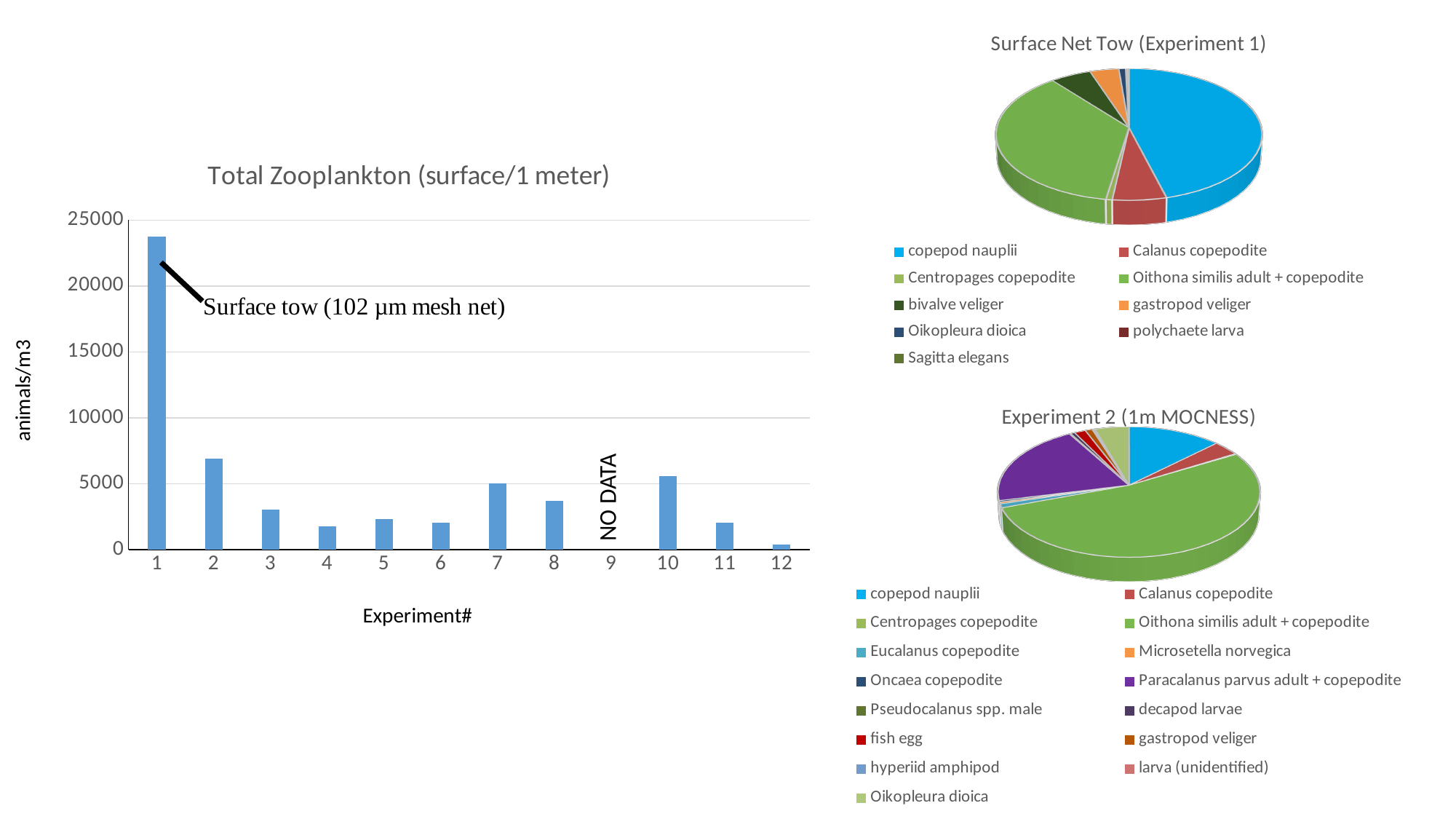
In the "Total Zooplankton (surface/1 meter)" chart, is the value for experiment 1 greater or less than 20000? greater How many experiments are labeled on the x axis of the "Total Zooplankton (surface/1 meter)" chart? 12 How many entries does the legend of the "Surface Net Tow (Experiment 1)" pie chart list? 9 In the "Total Zooplankton (surface/1 meter)" chart, which experiment is marked "NO DATA"? 9 In the "Total Zooplankton (surface/1 meter)" chart, which experiment has the highest value? 1 In the "Total Zooplankton (surface/1 meter)" chart, is the value for experiment 2 greater or less than 5000? greater In the "Experiment 2 (1m MOCNESS)" pie chart, which category has the largest slice? Oithona similis adult + copepodite What kind of chart is the "Total Zooplankton (surface/1 meter)" chart? bar chart In the "Total Zooplankton (surface/1 meter)" chart, which experiment has the lowest plotted value? 12 In the "Total Zooplankton (surface/1 meter)" chart, which is larger, the value for experiment 2 or experiment 3? experiment 2 In the "Total Zooplankton (surface/1 meter)" chart, which is larger, the value for experiment 10 or experiment 8? experiment 10 In the "Total Zooplankton (surface/1 meter)" chart, is the value for experiment 4 greater or less than 5000? less